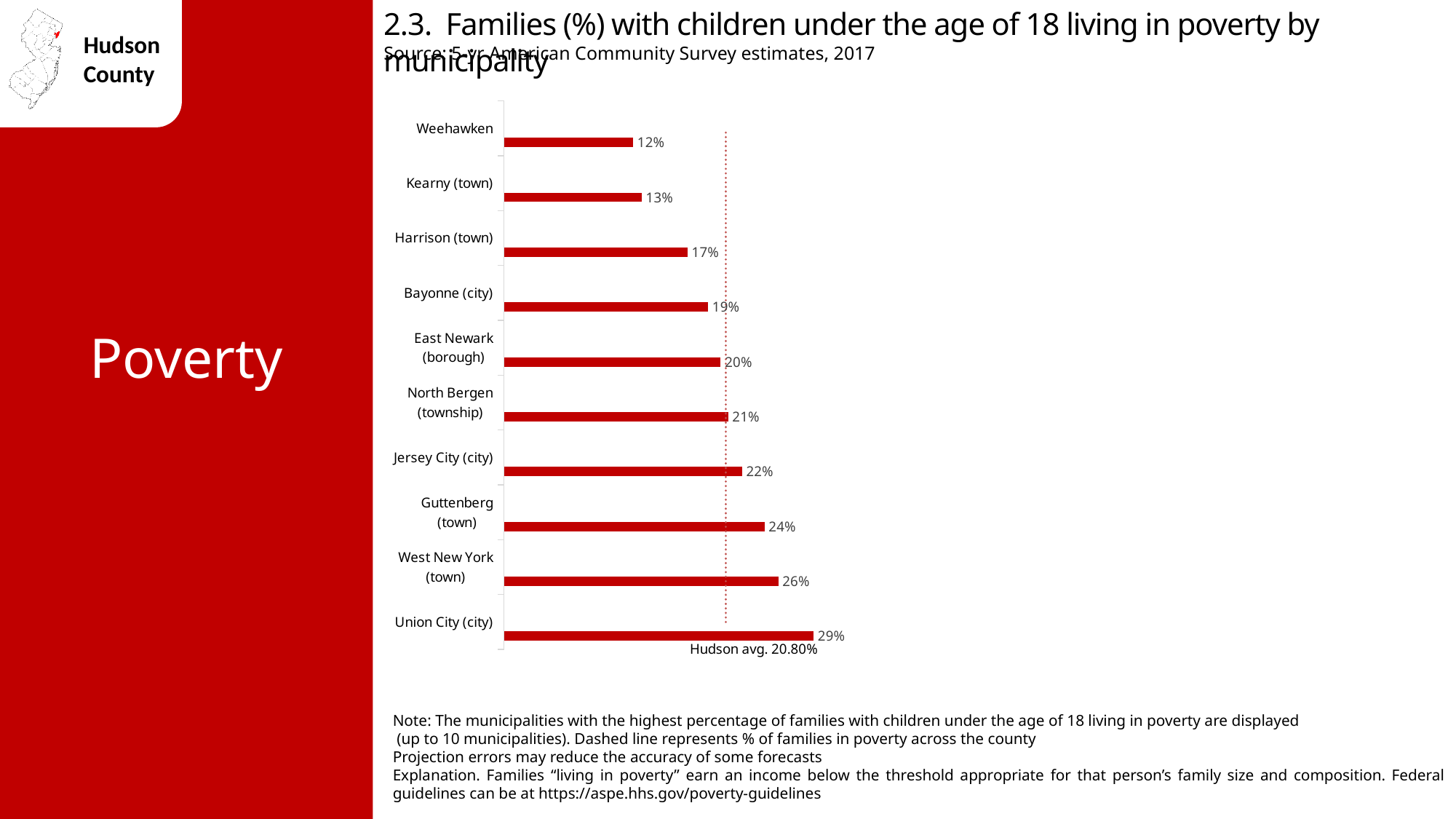
What is the value for Union City (city)? 29% What is the value for Guttenberg (town)? 24% What is the difference between the values for Union City (city) and Weehawken? 17% How many municipalities are shown on the chart? 10 Which is larger, the value for Bayonne (city) or the value for Harrison (town)? Bayonne (city) What is the difference between the values for West New York (town) and North Bergen (township)? 5% What is the value for Weehawken? 12% What value does the dashed line labelled Hudson avg. represent? 20.80% Which municipality has the lowest percentage shown on the chart? Weehawken Which municipality has the highest percentage of families with children under 18 living in poverty? Union City (city) What kind of chart is shown on the slide? Bar chart What is the value for Jersey City (city)? 22%